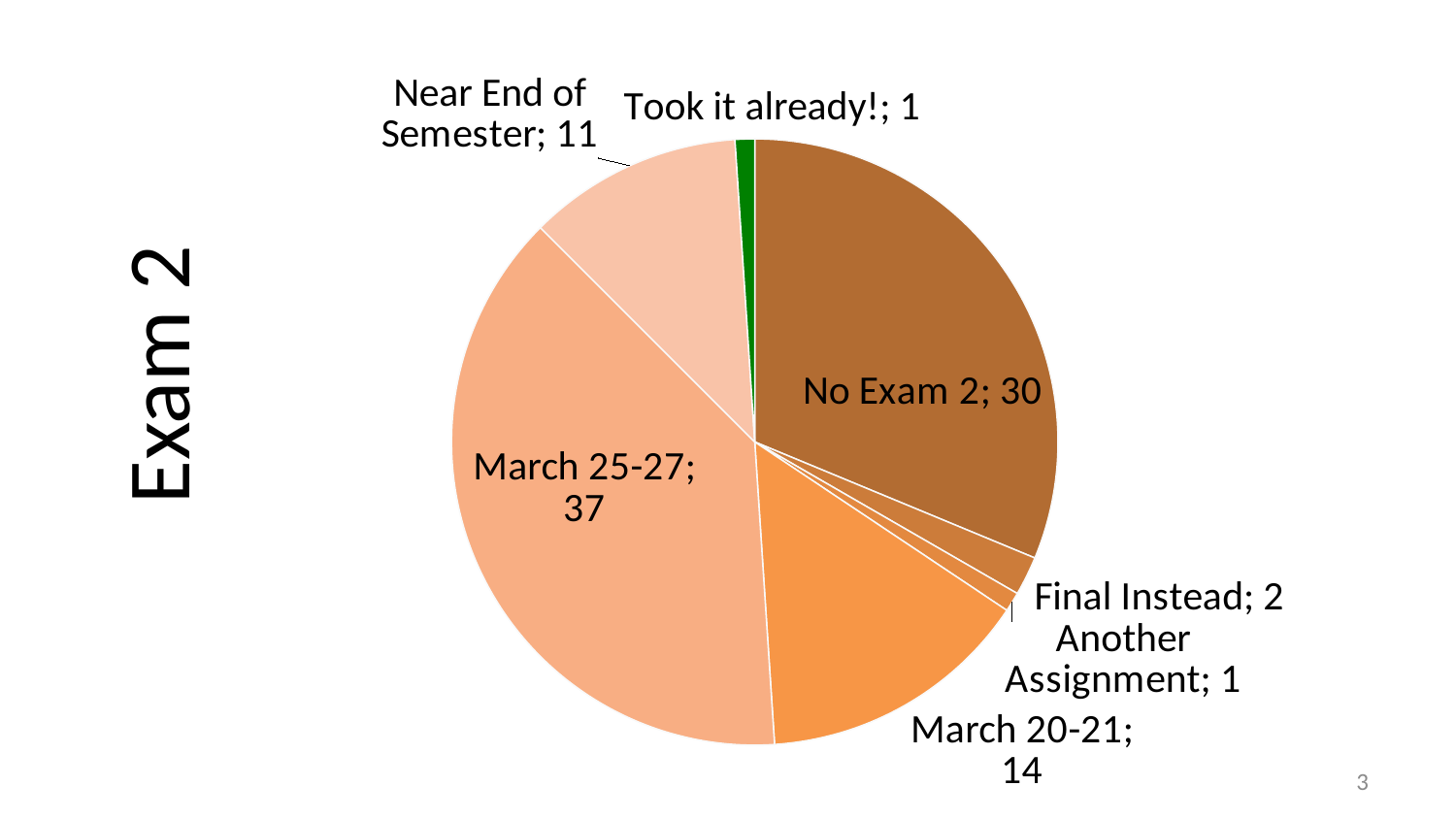
What type of chart is shown on the slide? pie chart What is the value for the "March 20-21" slice? 14 What is the value for the "March 25-27" slice? 37 What is the value for the "Final Instead" slice? 2 What is the value for the "Near End of Semester" slice? 11 Which slice has the largest value? March 25-27 What is the difference between the "No Exam 2" and "March 20-21" values? 16 How many slices does the pie chart have? 7 What is the value for the "No Exam 2" slice? 30 What is the difference between the "March 25-27" and "No Exam 2" values? 7 Which is larger, "March 20-21" or "Near End of Semester"? March 20-21 What is the title shown on the slide for this chart? Exam 2